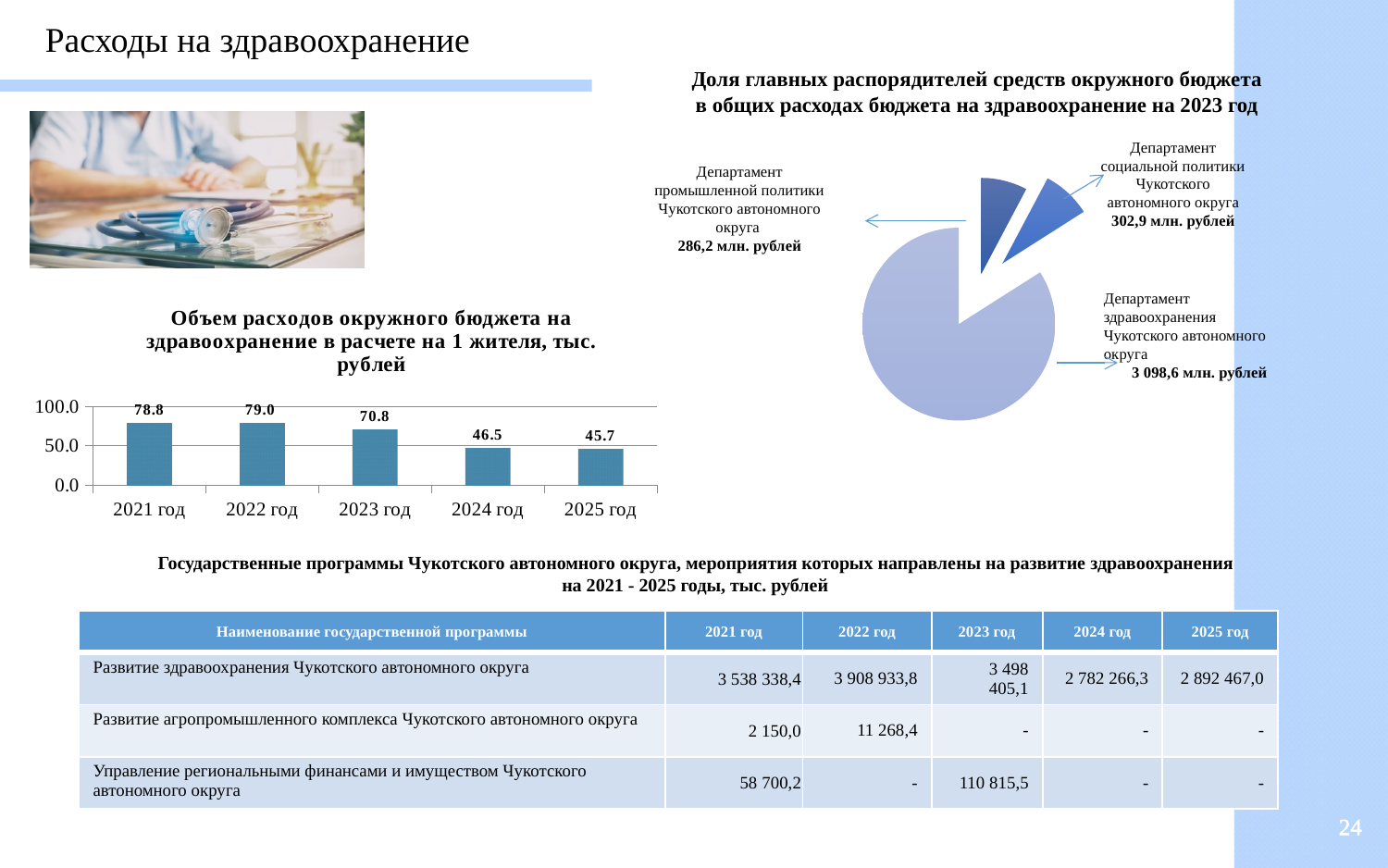
In the bar chart on the left, do the values generally rise or fall from 2021 год to 2025 год? fall What kind of chart is the chart titled "Объем расходов окружного бюджета на здравоохранение в расчете на 1 жителя, тыс. рублей"? bar chart In the bar chart on the left, which year has the lowest value? 2025 год What kind of chart is the chart titled "Доля главных распорядителей средств окружного бюджета в общих расходах бюджета на здравоохранение на 2023 год"? pie chart In the bar chart on the left, what is the value for 2025 год? 45.7 In the bar chart on the left, what is the value for 2023 год? 70.8 In the bar chart on the left, how many years are shown on the x axis? 5 In the bar chart on the left, which is larger: the value for 2021 год or the value for 2024 год? 2021 год In the pie chart on the right, what is the value for Департамент здравоохранения Чукотского автономного округа? 3 098,6 млн. рублей In the bar chart on the left, which year has the highest value? 2022 год In the pie chart on the right, what is the difference between the values for Департамент социальной политики Чукотского автономного округа and Департамент промышленной политики Чукотского автономного округа? 16,7 млн. рублей In the bar chart on the left, what is the difference between the values for 2021 год and 2025 год? 33.1